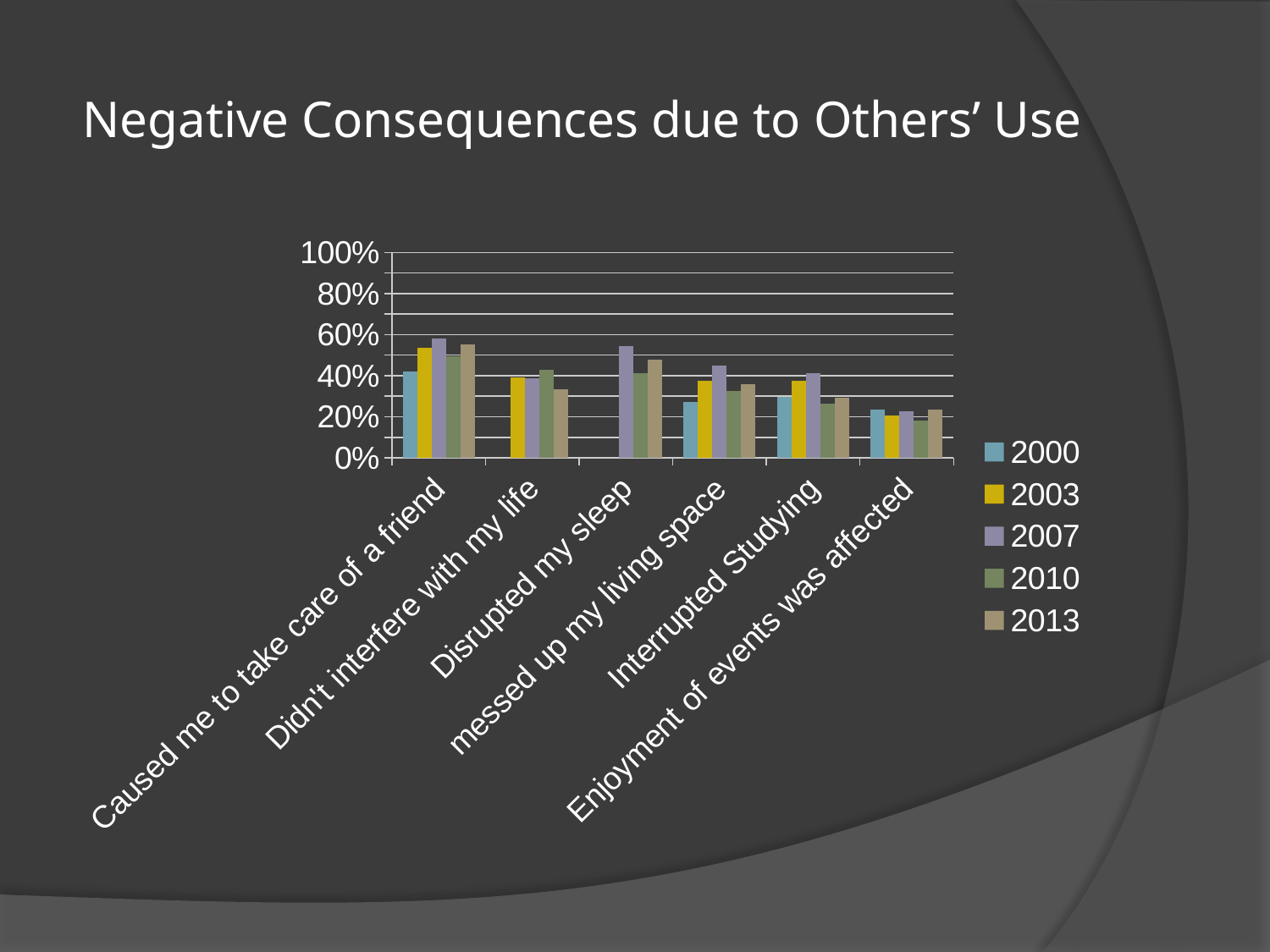
Which years are listed in the legend? 2000, 2003, 2007, 2010, 2013 How many categories are shown on the x axis? 6 What kind of chart is shown on the slide? Bar chart Which year has the lowest value for "messed up my living space"? 2000 For "Caused me to take care of a friend", which is larger: the 2000 value or the 2007 value? 2007 Is the 2007 value for "Disrupted my sleep" greater or less than 40%? greater How many series does the legend list? 5 Which year has the highest value for "messed up my living space"? 2007 Is the 2000 value for "messed up my living space" greater or less than 40%? less Is the 2010 value for "Enjoyment of events was affected" greater or less than 40%? less What is the title of the chart? Negative Consequences due to Others' Use